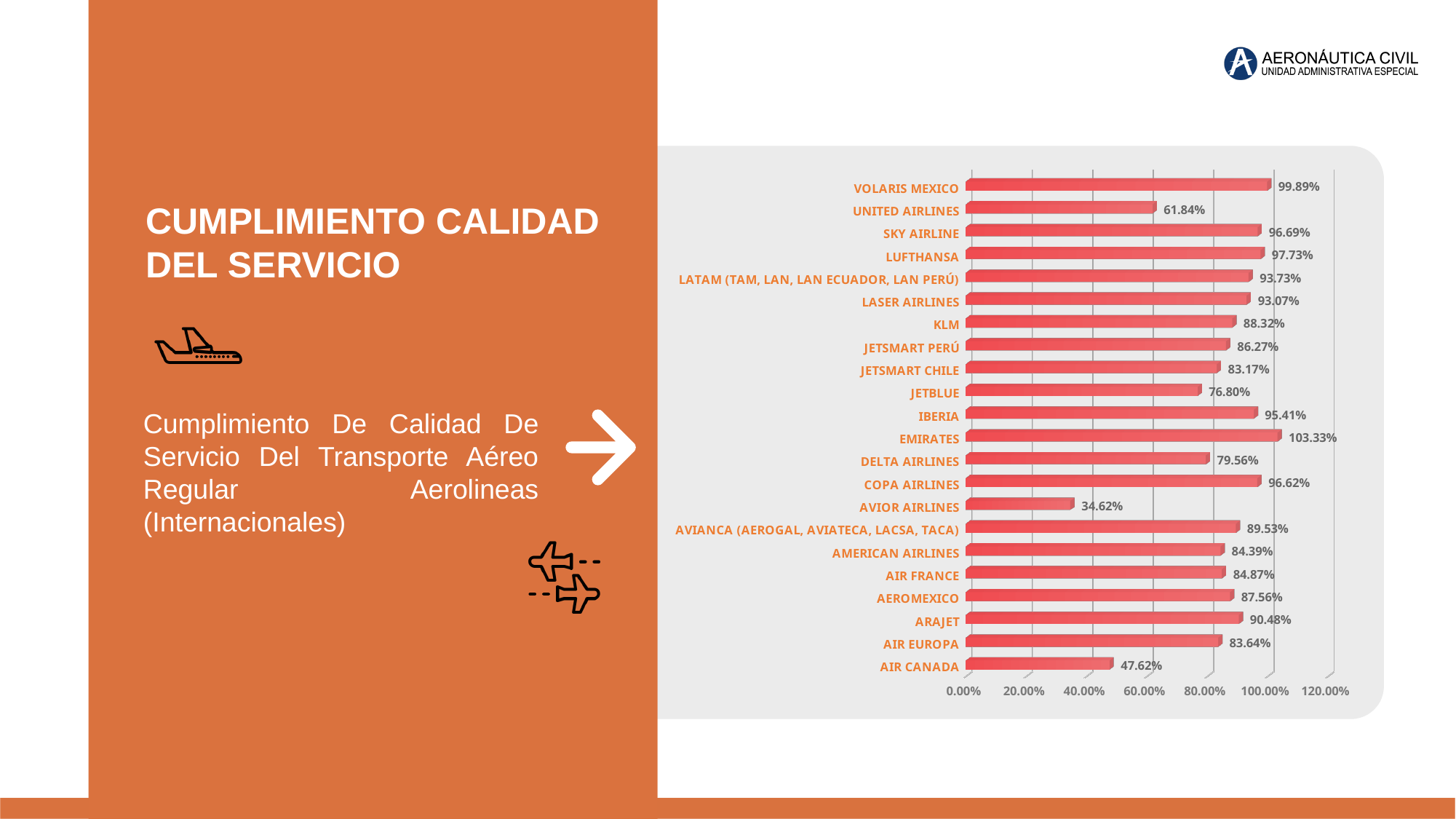
What is the value for JETBLUE? 76.80% What is the difference between the values for VOLARIS MEXICO and UNITED AIRLINES? 38.05% What is the value for AIR CANADA? 47.62% Which has a larger value, KLM or DELTA AIRLINES? KLM Which airline has the highest value? EMIRATES Is the value for UNITED AIRLINES greater or less than 80.00%? less What is the difference between the values for AIR CANADA and AVIOR AIRLINES? 13.00% What is the value for VOLARIS MEXICO? 99.89% How many airlines are shown in the chart? 22 Which airline has the lowest value? AVIOR AIRLINES What is the value for EMIRATES? 103.33% What kind of chart is shown on the slide? bar chart